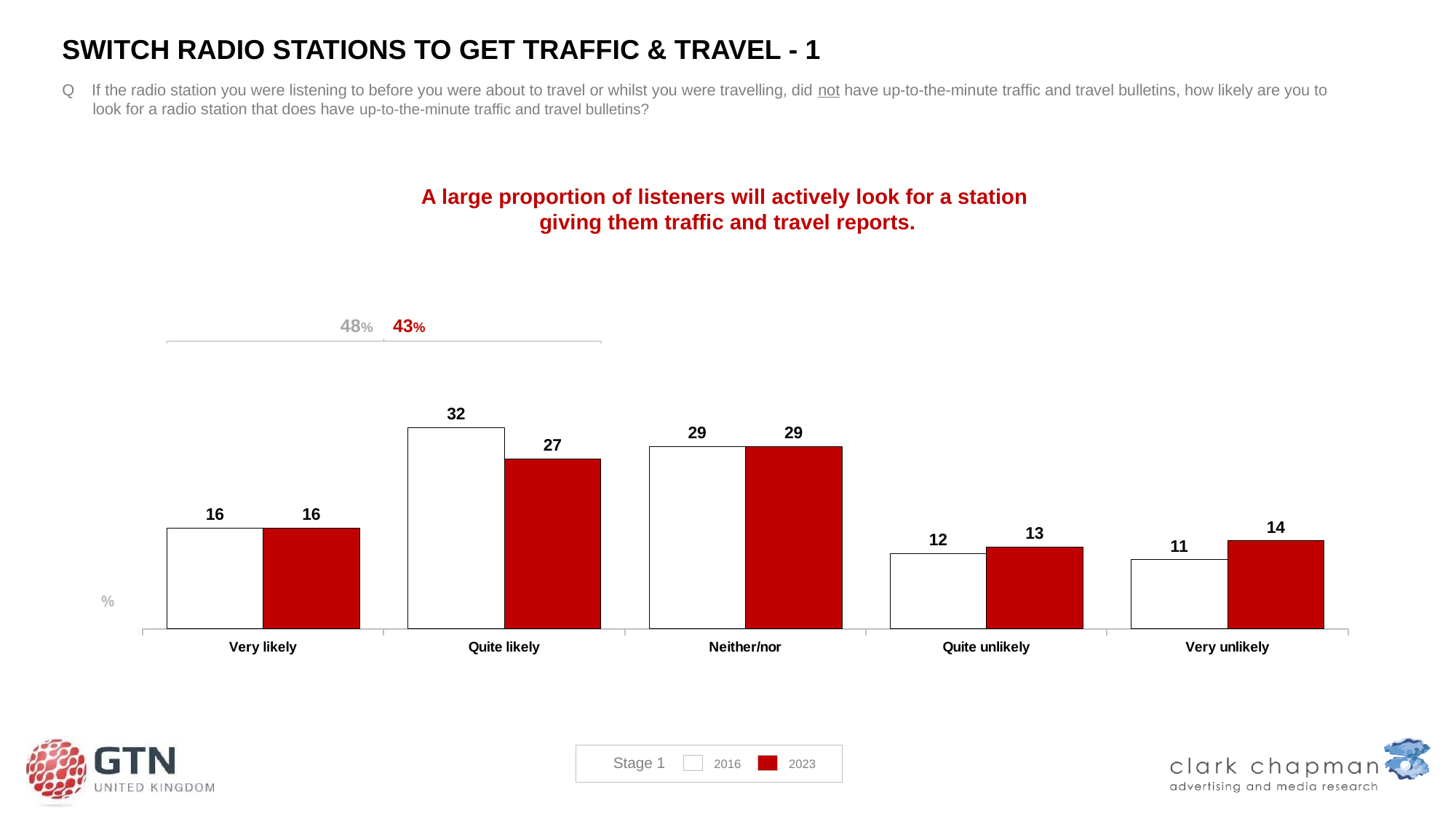
Which is larger for Quite unlikely, the 2016 value or the 2023 value? 2023 Which category has the lowest 2016 value? Very unlikely How many categories are shown on the x axis? 5 What is the 2023 value for Very unlikely? 14 What kind of chart is shown on the slide? Bar chart How many series does the legend list? 2 What is the 2023 value for Neither/nor? 29 What is the 2016 value for Quite likely? 32 What is the difference between the 2016 and 2023 values for Quite likely? 5 Which category has the highest 2016 value? Quite likely What is the combined 2023 percentage shown above the Very likely and Quite likely bars? 43% Which colour represents the 2023 series in the legend? Red